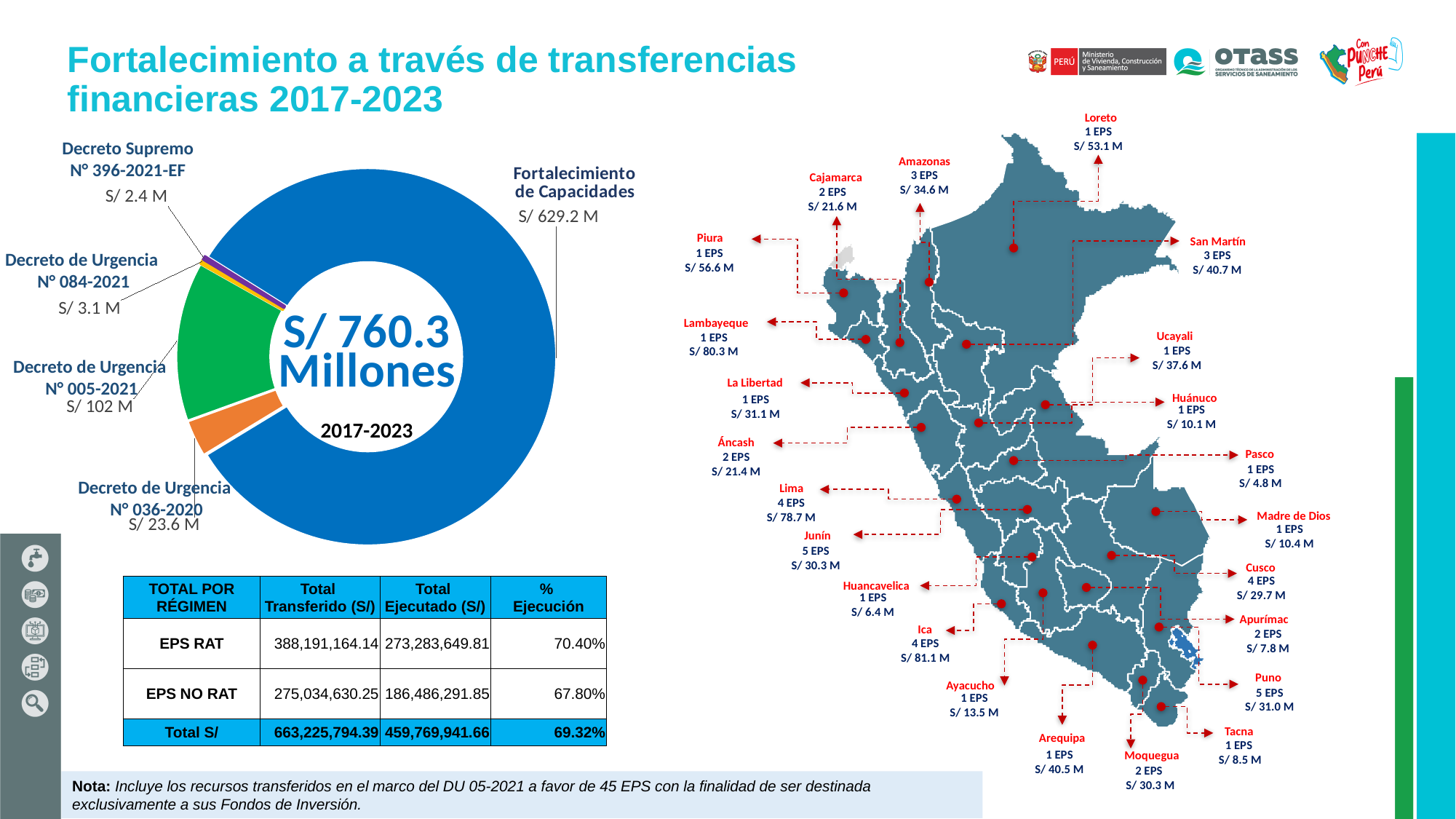
How many segments does the donut chart have? 5 In the donut chart, what is the value for Decreto de Urgencia N° 005-2021? S/ 102 M In the donut chart, what is the value for Decreto Supremo N° 396-2021-EF? S/ 2.4 M In the donut chart, what is the difference between Fortalecimiento de Capacidades and Decreto de Urgencia N° 005-2021? S/ 527.2 M What type of chart is shown on the left of the slide? Donut (pie) chart In the donut chart, which is larger: Decreto de Urgencia N° 036-2020 or Decreto de Urgencia N° 084-2021? Decreto de Urgencia N° 036-2020 What total amount is shown in the centre of the donut chart? S/ 760.3 Millones In the donut chart, what is the value for Decreto de Urgencia N° 036-2020? S/ 23.6 M Which segment of the donut chart has the smallest value? Decreto Supremo N° 396-2021-EF In the donut chart, what is the value for Fortalecimiento de Capacidades? S/ 629.2 M Which segment of the donut chart has the largest value? Fortalecimiento de Capacidades What period is shown in the centre of the donut chart? 2017-2023